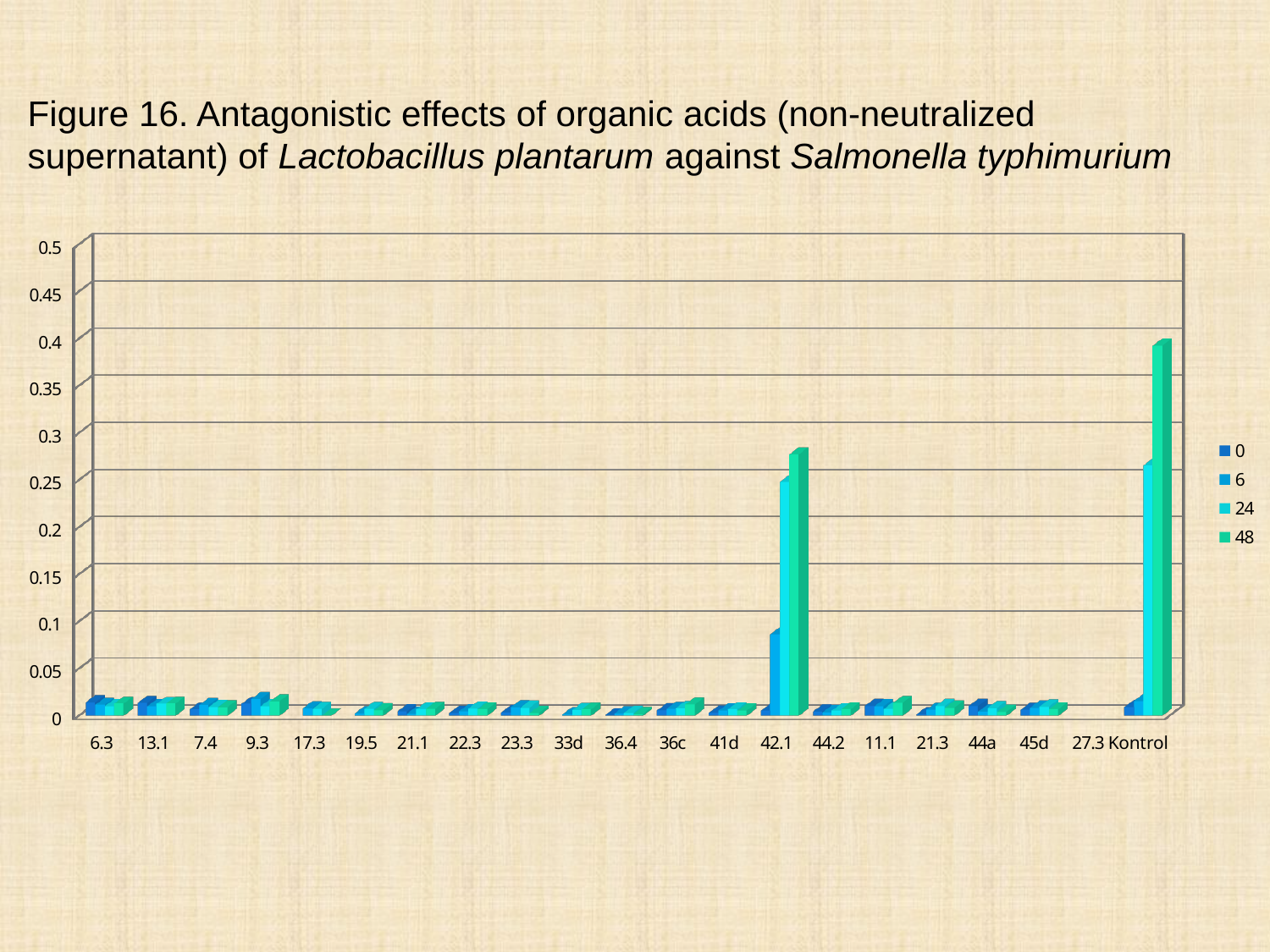
Is the value of the 48 series for Kontrol greater or less than 0.35? greater What kind of chart is shown on the slide? bar chart Which series has the tallest bar for the Kontrol category? 48 Which category has the highest bar in the chart? Kontrol Is the value of the 6 series for 42.1 greater or less than 0.15? less Is the value of the 24 series for 42.1 greater or less than 0.3? less How many series does the legend list? 4 Which is larger, the 48 series value for Kontrol or the 48 series value for 42.1? Kontrol How many categories are shown on the x axis? 21 What are the legend entries of the chart? 0, 6, 24, 48